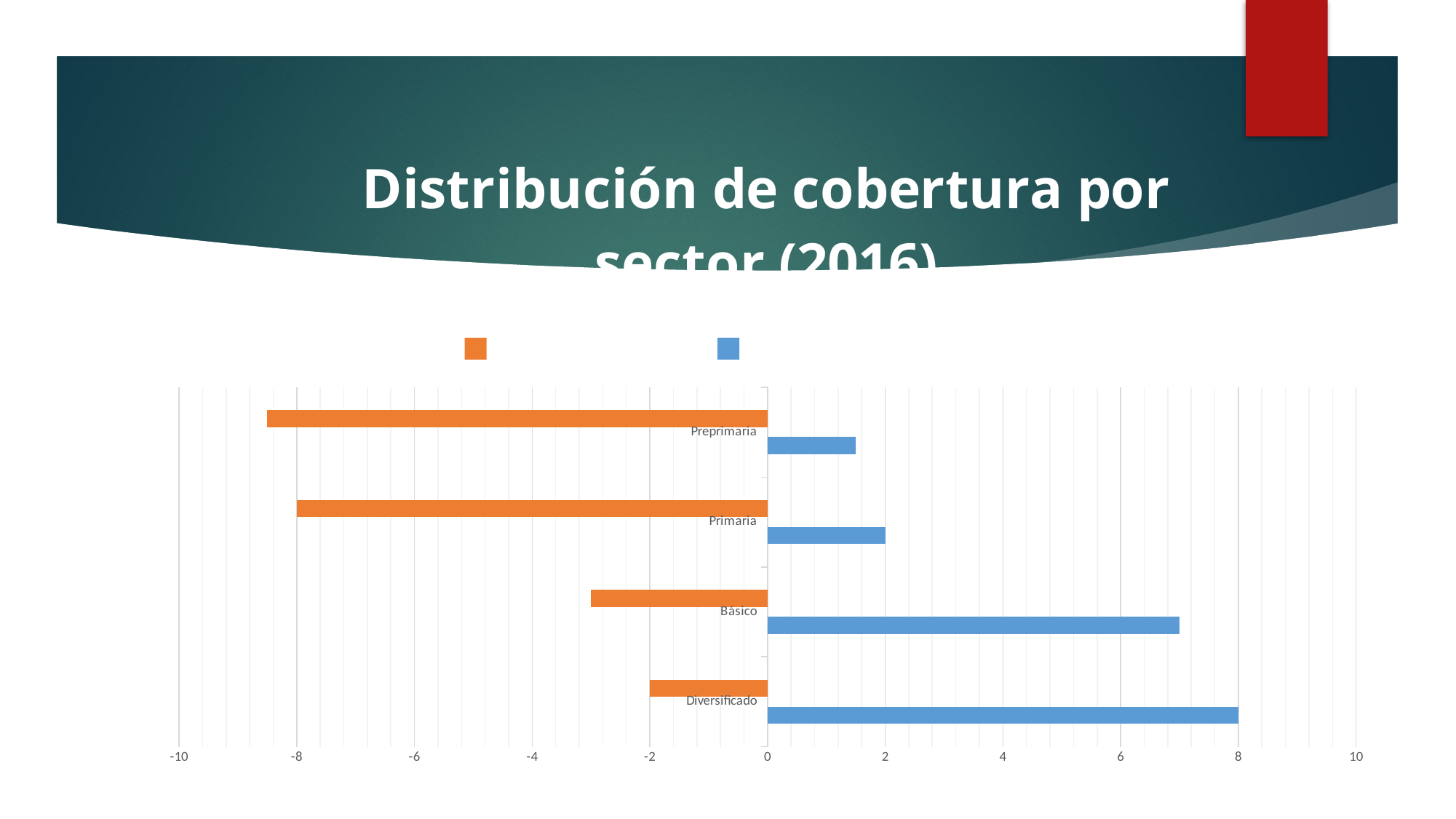
How many series does the legend list? 2 Is the value of the blue bar for Básico greater or less than 6? greater How many categories are shown on the chart? 4 Which has the larger blue bar value, Básico or Primaria? Básico Which category has the shortest blue bar? Preprimaria What is the value of the orange bar for Diversificado? -2 Which category has the longest blue bar? Diversificado What is the value of the blue bar for Primaria? 2 What is the difference between the blue bar values for Diversificado and Primaria? 6 What is the value of the blue bar for Diversificado? 8 What kind of chart is shown on the slide? Bar chart What is the value of the orange bar for Primaria? -8